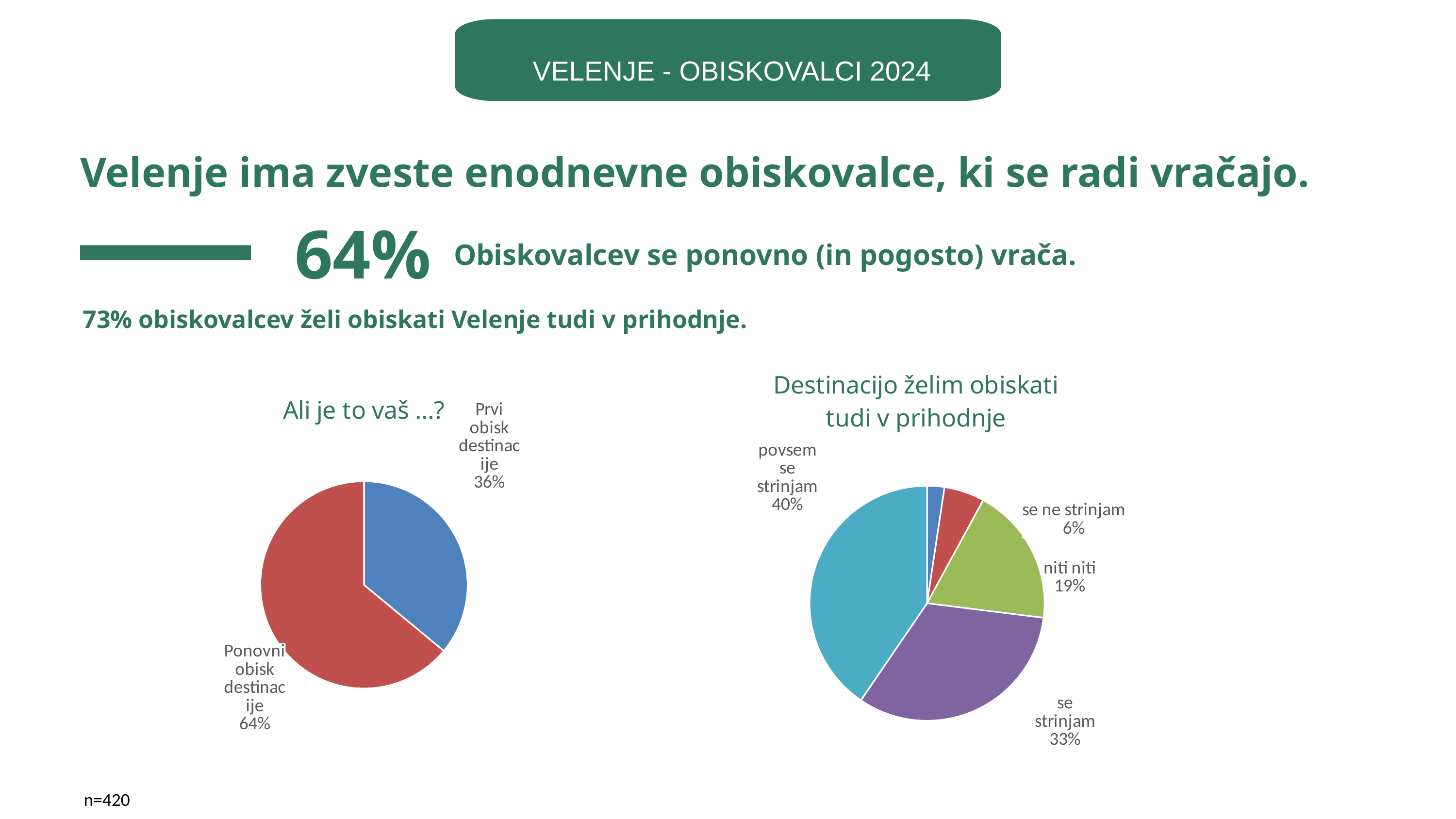
In the right pie chart 'Destinacijo želim obiskati tudi v prihodnje', what share is 'niti niti'? 19% In the right pie chart 'Destinacijo želim obiskati tudi v prihodnje', what share is 'se ne strinjam'? 6% In the right pie chart 'Destinacijo želim obiskati tudi v prihodnje', which labelled slice is the largest? povsem se strinjam In the right pie chart 'Destinacijo želim obiskati tudi v prihodnje', what share is 'se strinjam'? 33% In the right pie chart 'Destinacijo želim obiskati tudi v prihodnje', what is the difference between 'povsem se strinjam' and 'se strinjam'? 7% In the left pie chart 'Ali je to vaš ...?', what share is 'Prvi obisk destinacije'? 36% In the left pie chart 'Ali je to vaš ...?', what share is 'Ponovni obisk destinacije'? 64% What kind of chart is the left chart 'Ali je to vaš ...?'? Pie chart How many slices does the right pie chart 'Destinacijo želim obiskati tudi v prihodnje' have? 5 In the left pie chart 'Ali je to vaš ...?', what is the difference between 'Ponovni obisk destinacije' and 'Prvi obisk destinacije'? 28% In the right pie chart 'Destinacijo želim obiskati tudi v prihodnje', what share is 'povsem se strinjam'? 40% In the left pie chart 'Ali je to vaš ...?', which slice is larger: 'Prvi obisk destinacije' or 'Ponovni obisk destinacije'? Ponovni obisk destinacije